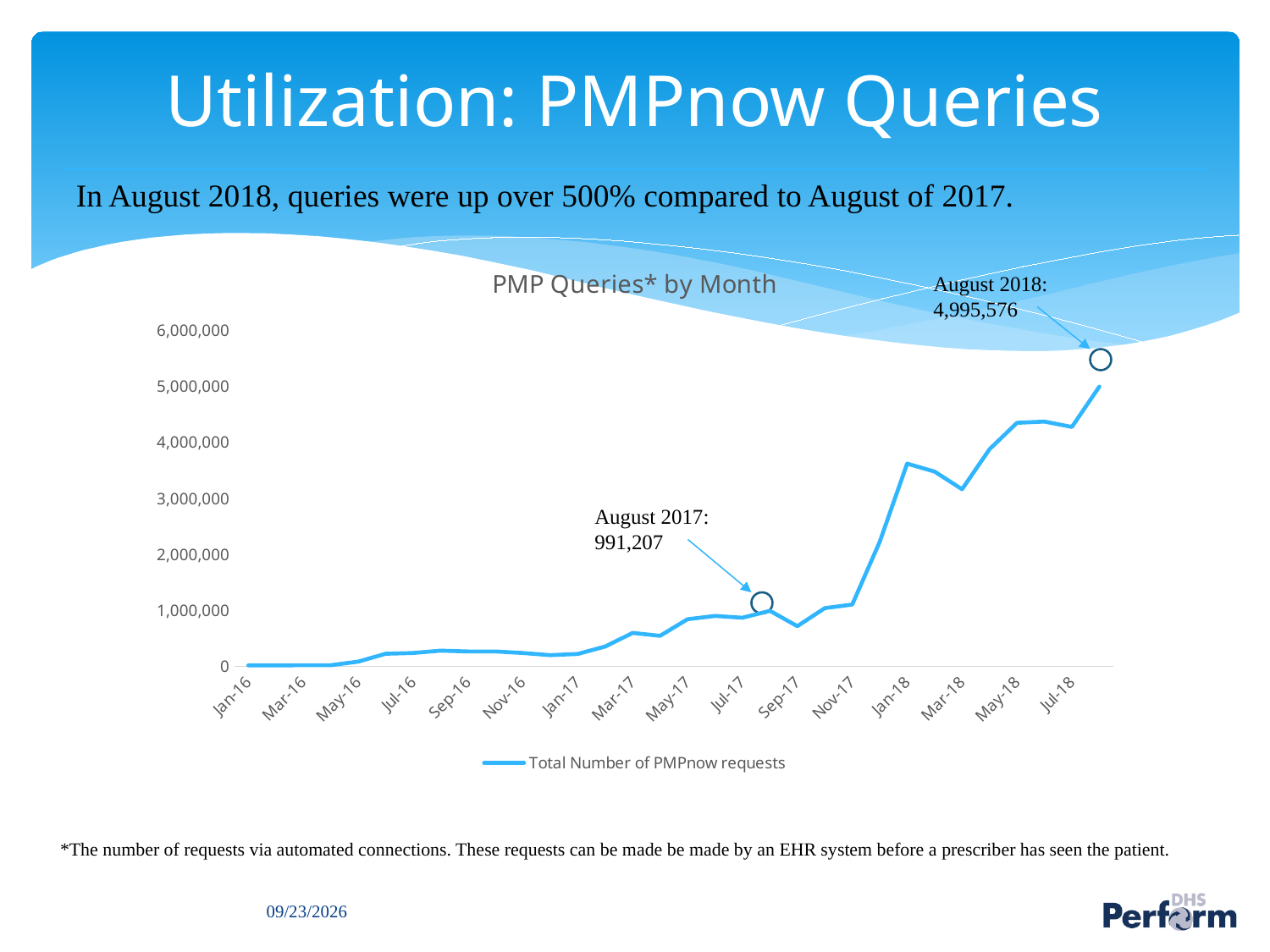
How many series does the legend list? 1 What kind of chart is shown on the slide? line chart Is the value for Jan-17 greater or less than 1,000,000? less Which month has the highest number of queries? August 2018 What is the number of PMP queries for August 2017? 991,207 What is the number of PMP queries for August 2018? 4,995,576 Which is larger, the value for August 2017 or the value for August 2018? August 2018 What is the difference between the August 2018 and August 2017 query values? 4,004,369 Is the value for Jan-18 greater or less than 3,000,000? greater What is the name of the series shown in the legend? Total Number of PMPnow requests What is the title of the chart? PMP Queries* by Month Do the values generally rise or fall from Jan-16 to Jul-18? rise